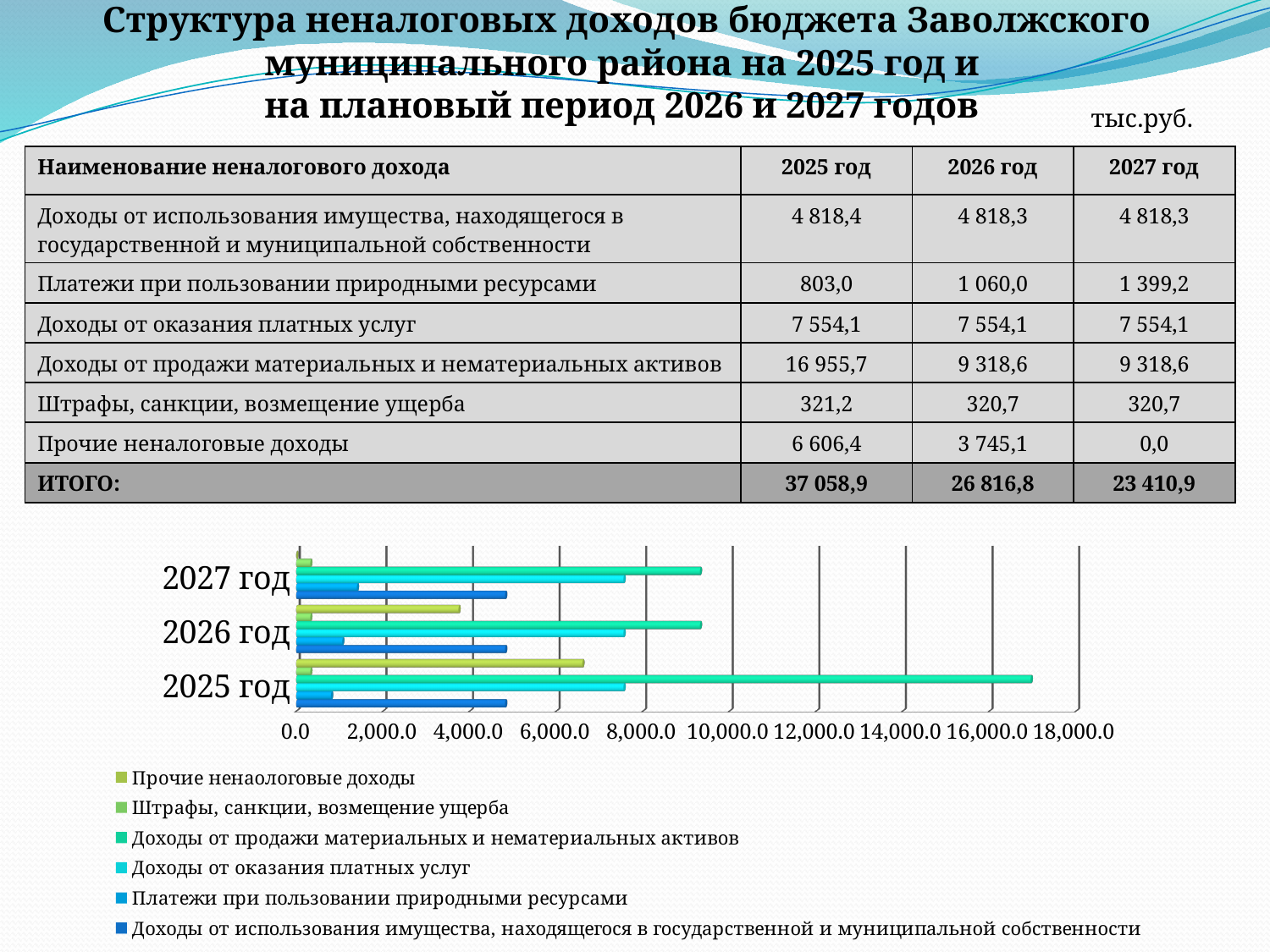
Is the value for Доходы от продажи материальных и нематериальных активов in 2025 год greater or less than 16,000.0? greater Is the value for Платежи при пользовании природными ресурсами in 2027 год greater or less than 2,000.0? less How many year categories are plotted on the chart's vertical axis? 3 What is the value of Штрафы, санкции, возмещение ущерба for 2026 год? 320,7 What kind of chart is shown on the slide? bar chart How many series does the chart's legend list? 6 What is the difference between Доходы от продажи материальных и нематериальных активов in 2025 год and in 2026 год? 7 637,1 Do the values for Платежи при пользовании природными ресурсами rise or fall from 2025 год to 2027 год? rise Which is larger: Платежи при пользовании природными ресурсами in 2025 год or in 2027 год? 2027 год Is the value for Доходы от оказания платных услуг in 2025 год greater or less than 8,000.0? less In which year does the chart show the longest bar of all? 2025 год What is the value of Платежи при пользовании природными ресурсами for 2027 год? 1 399,2